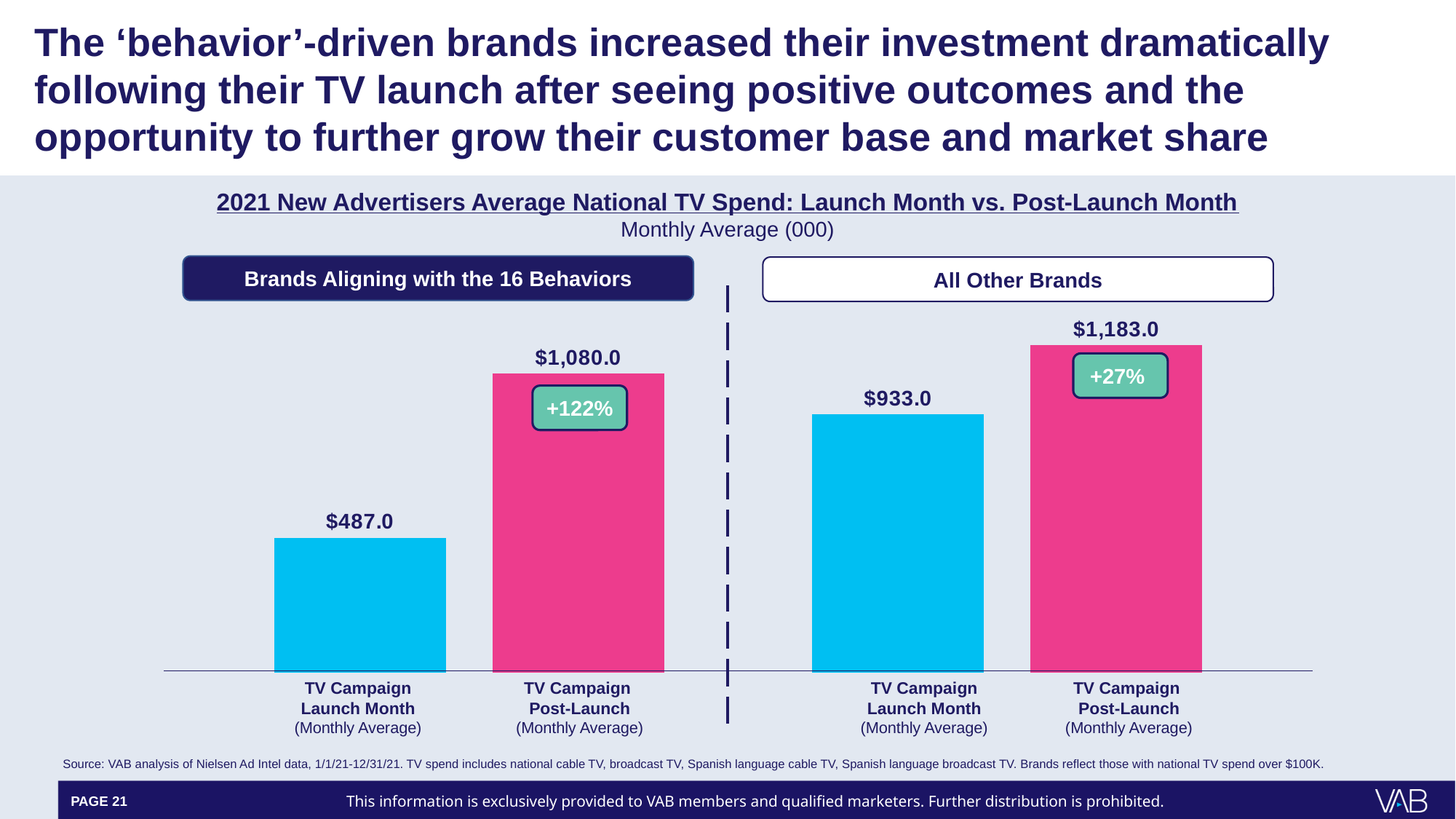
What percentage increase is shown on the Post-Launch bar for All Other Brands? +27% What is the TV Campaign Post-Launch monthly average spend for All Other Brands? $1,183.0 What is the difference between the Post-Launch and Launch Month spend for Brands Aligning with the 16 Behaviors? $593.0 What is the TV Campaign Launch Month monthly average spend for All Other Brands? $933.0 What is the difference between the Post-Launch and Launch Month spend for All Other Brands? $250.0 Which bar in the chart has the highest value? All Other Brands, TV Campaign Post-Launch What is the TV Campaign Post-Launch monthly average spend for Brands Aligning with the 16 Behaviors? $1,080.0 Which is larger: the Launch Month spend for All Other Brands or the Post-Launch spend for Brands Aligning with the 16 Behaviors? Post-Launch spend for Brands Aligning with the 16 Behaviors What kind of chart is shown on the slide? Bar chart Which bar in the chart has the lowest value? Brands Aligning with the 16 Behaviors, TV Campaign Launch Month What percentage increase is shown on the Post-Launch bar for Brands Aligning with the 16 Behaviors? +122% What is the TV Campaign Launch Month monthly average spend for Brands Aligning with the 16 Behaviors? $487.0